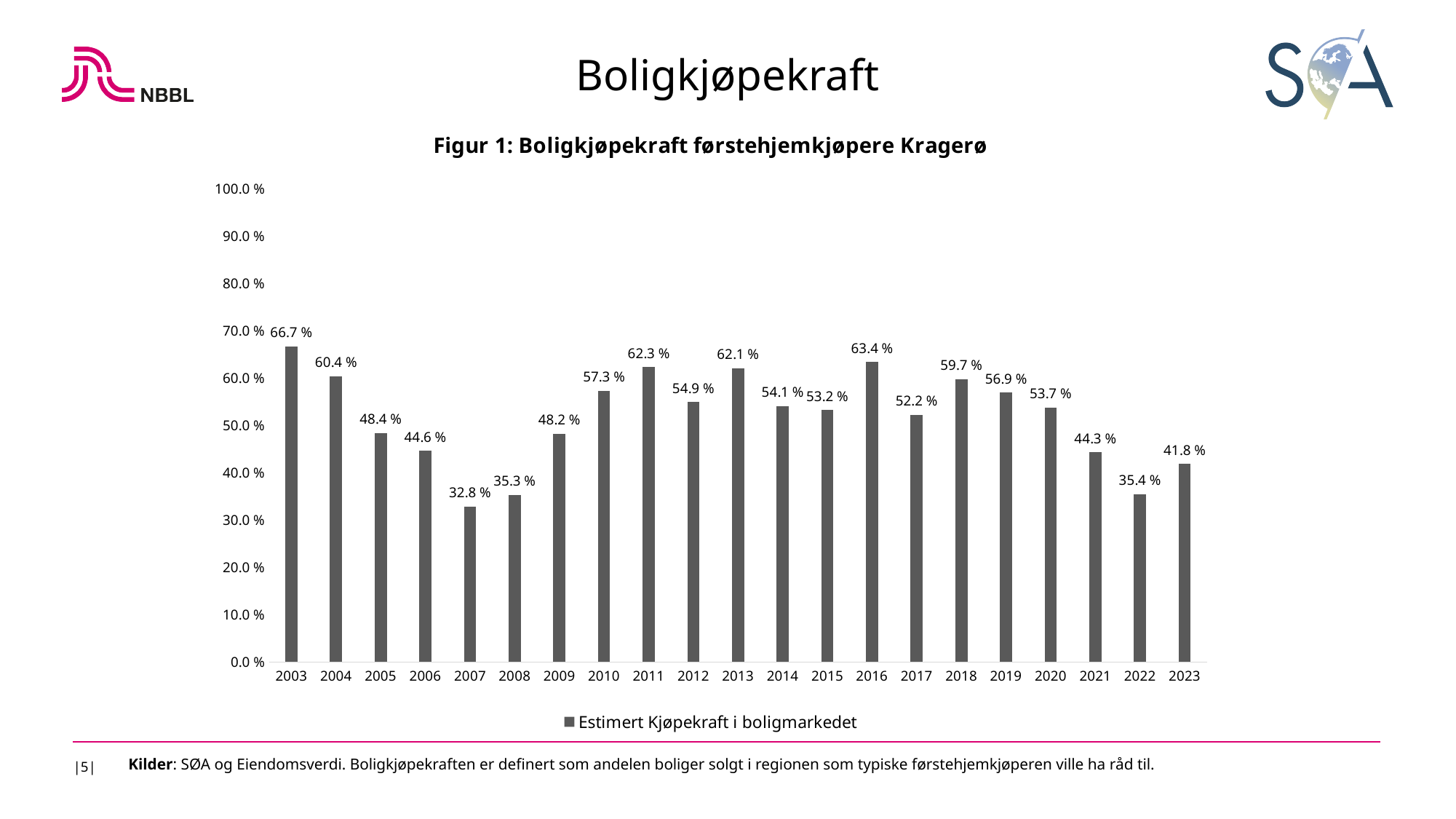
How many series does the legend list? 1 Is the value for 2022 greater or less than 40.0 %? less What is the value for 2016? 63.4 % What is the title of the chart? Figur 1: Boligkjøpekraft førstehjemkjøpere Kragerø Which is larger, the value for 2011 or the value for 2013? 2011 What is the value for 2023? 41.8 % How many years are shown on the x axis? 21 Which year has the highest value? 2003 Which year has the lowest value? 2007 What is the value for 2003? 66.7 % What is the difference between the values for 2003 and 2007? 33.9 % What kind of chart is shown? bar chart